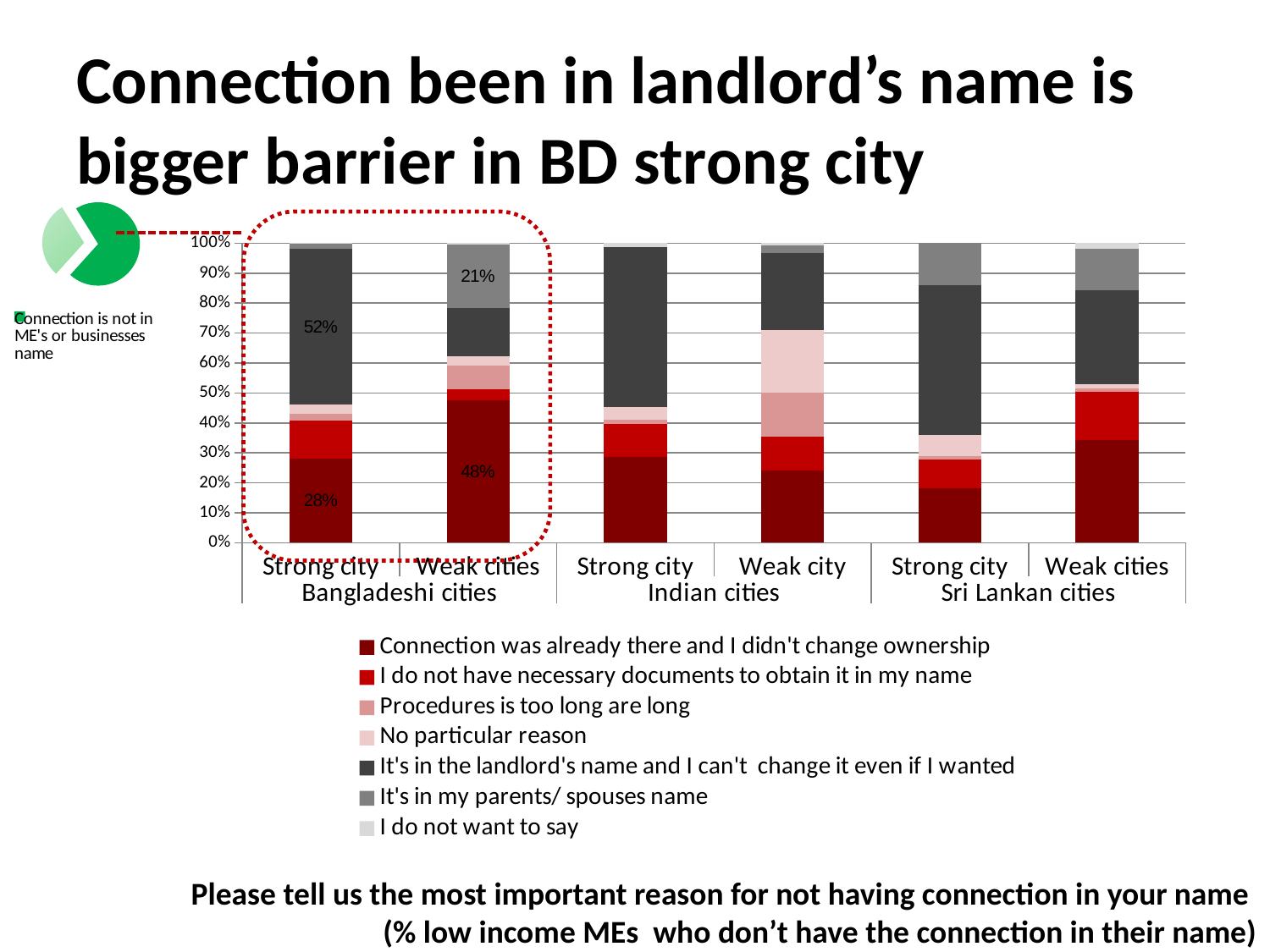
Is the 'Connection was already there and I didn't change ownership' share for the Indian Weak city greater or less than 30%? less Which group of cities is highlighted with a red dotted outline on the chart? Bangladeshi cities How many stacked bars are plotted in the chart? 6 In the Bangladeshi Strong city bar, what percentage is shown for 'It's in the landlord's name and I can't change it even if I wanted'? 52% How many series does the legend list? 7 How many percentage points higher is the 'Connection was already there' share in the Bangladeshi Weak cities than in the Bangladeshi Strong city? 20 percentage points What kind of chart is the main chart on the slide? Stacked bar chart Among the Bangladeshi cities, which bar has the larger share for 'It's in the landlord's name and I can't change it even if I wanted': Strong city or Weak cities? Strong city In the Bangladeshi Strong city bar, what percentage is shown for 'Connection was already there and I didn't change ownership'? 28% In the Bangladeshi Weak cities bar, what percentage is shown for 'Connection was already there and I didn't change ownership'? 48%